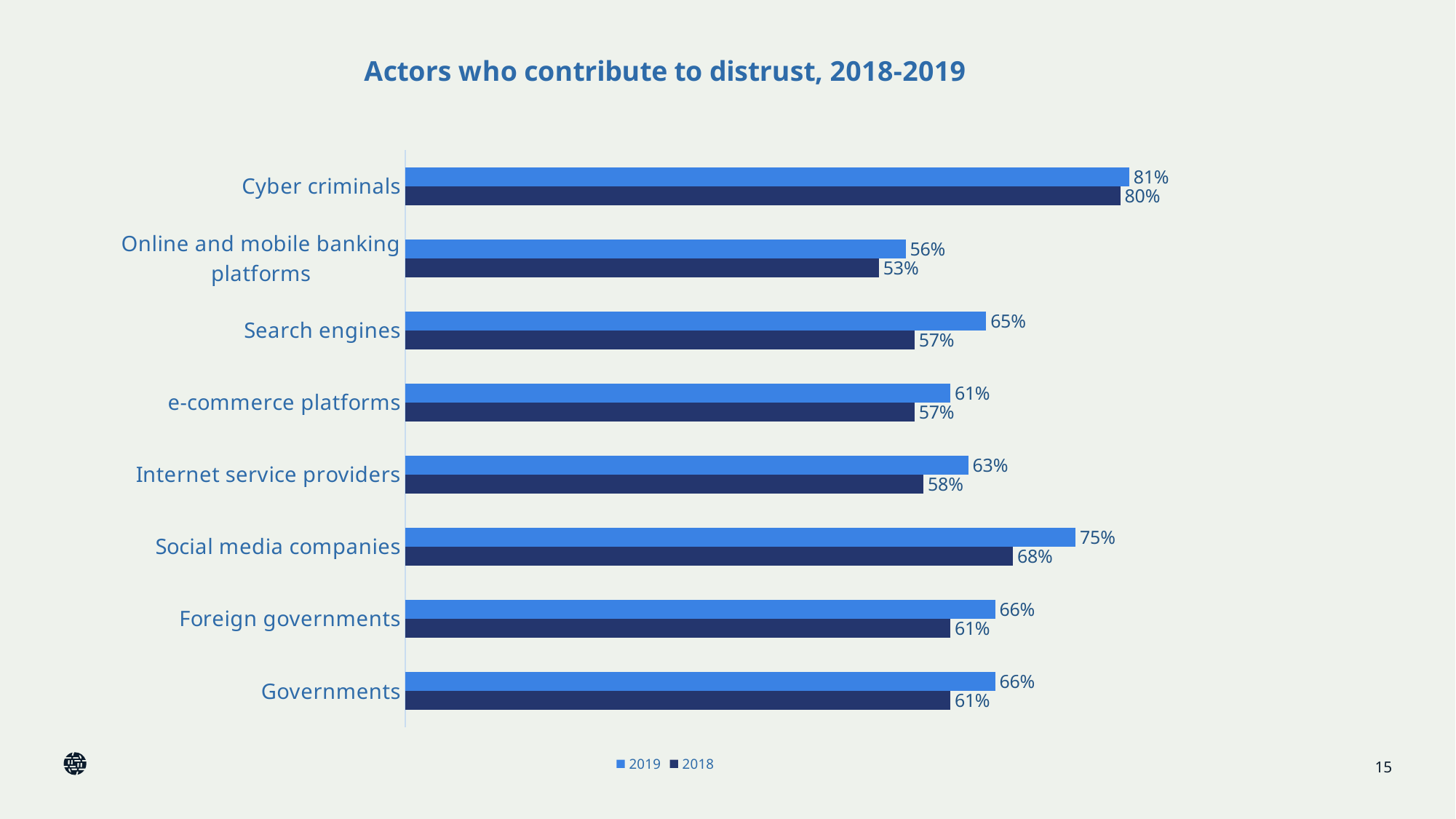
How many categories are shown on the chart? 8 Which category has the highest 2019 value? Cyber criminals What is the 2018 value for Social media companies? 68% What is the 2019 value for Online and mobile banking platforms? 56% What is the 2019 value for Cyber criminals? 81% Which category has the lowest 2018 value? Online and mobile banking platforms Which series is shown in the darker blue colour? 2018 What kind of chart is shown on the slide? Bar chart How many series does the legend list? 2 Which is larger: the 2019 value for Social media companies or the 2019 value for Foreign governments? Social media companies What is the title of the chart? Actors who contribute to distrust, 2018-2019 What is the difference between the 2019 and 2018 values for Search engines? 8%